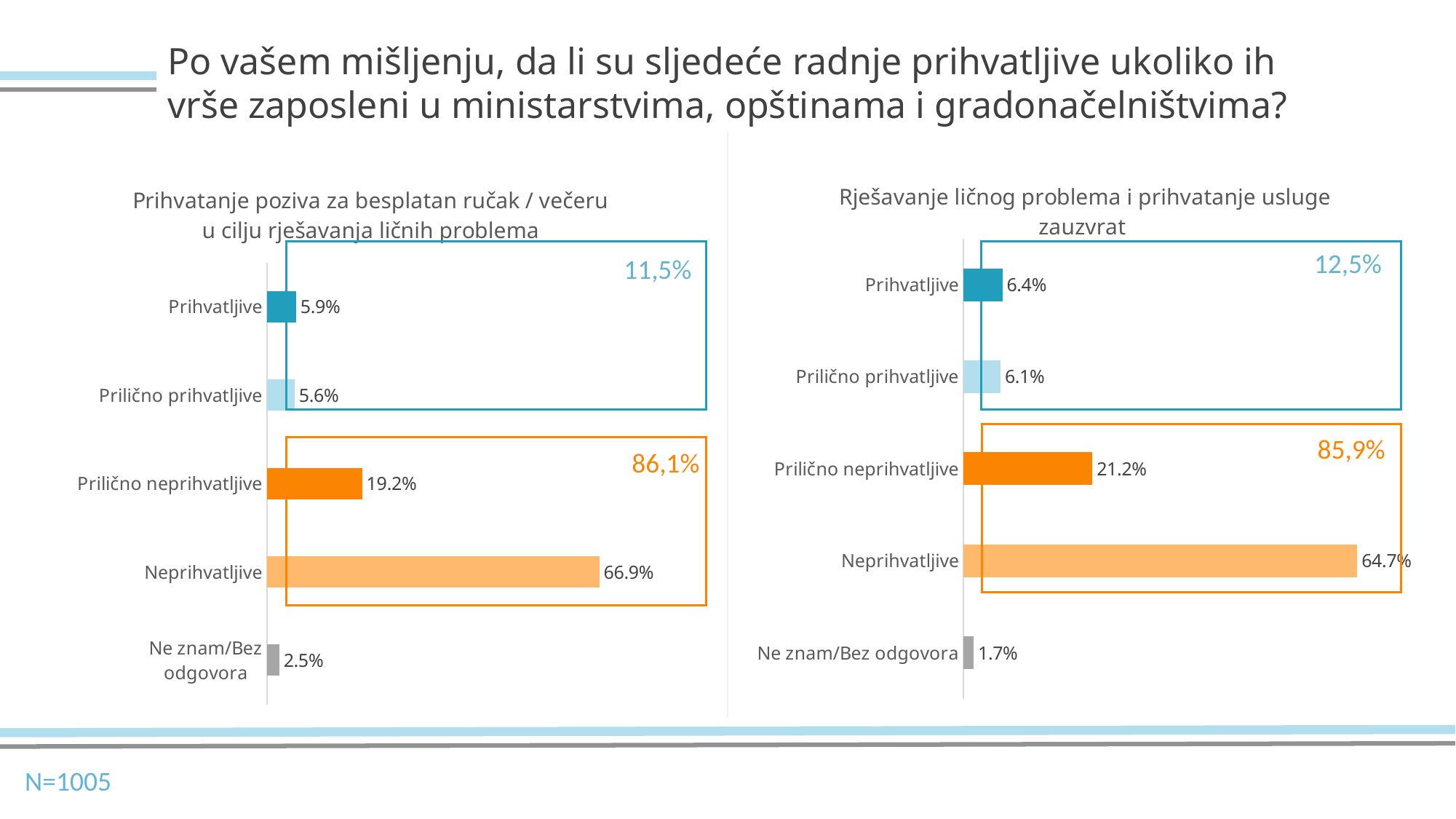
How many categories does the left chart show? 5 In the left chart (Prihvatanje poziva za besplatan ručak / večeru u cilju rješavanja ličnih problema), what is the value for Neprihvatljive? 66.9% In the left chart, which category has the lowest value? Ne znam/Bez odgovora In the right chart (Rješavanje ličnog problema i prihvatanje usluge zauzvrat), what is the value for Prilično neprihvatljive? 21.2% What type of chart is used on the right side of the slide? Bar chart In the right chart, what is the value for Prihvatljive? 6.4% In the right chart, what combined percentage is shown in the orange box for the unacceptable categories? 85,9% In the left chart, what is the value for Ne znam/Bez odgovora? 2.5% In the right chart, which category has the highest value? Neprihvatljive In the left chart, what combined percentage is shown in the blue box for the acceptable categories? 11,5% In the right chart, which is larger: Prihvatljive or Prilično prihvatljive? Prihvatljive In the left chart, what is the difference between Neprihvatljive and Prilično neprihvatljive? 47.7%